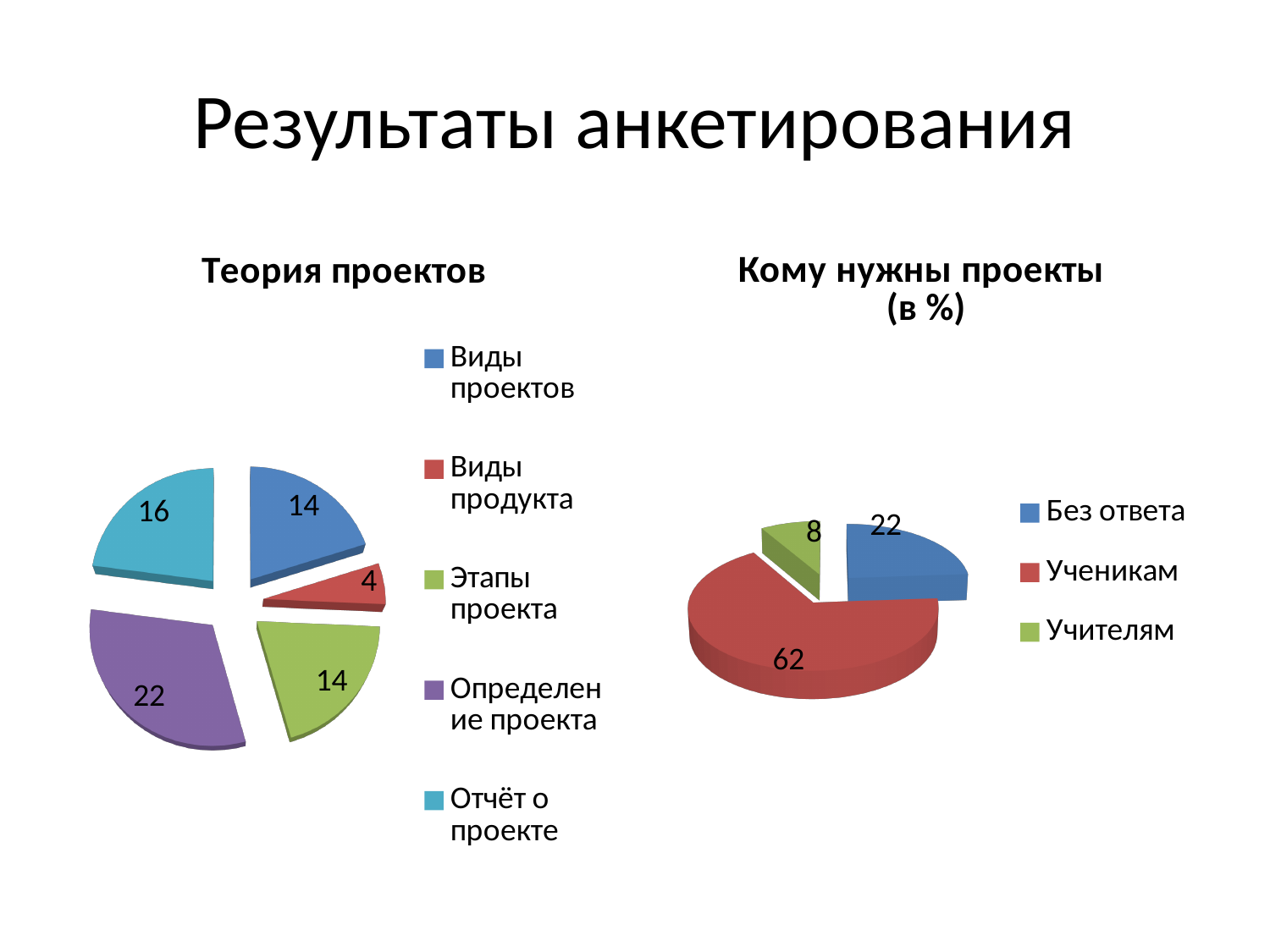
In the chart titled "Теория проектов", what is the value for "Виды продукта"? 4 In the chart titled "Теория проектов", which category has the smallest value? Виды продукта In the chart titled "Кому нужны проекты (в %)", what is the value for "Учителям"? 8 In the chart titled "Кому нужны проекты (в %)", what is the difference between the values for "Ученикам" and "Без ответа"? 40 In the chart titled "Теория проектов", which category has the largest value? Определение проекта In the chart titled "Теория проектов", how many categories are shown? 5 In the chart titled "Теория проектов", what is the value for "Определение проекта"? 22 In the chart titled "Кому нужны проекты (в %)", which category has the largest value? Ученикам In the chart titled "Кому нужны проекты (в %)", how many entries does the legend list? 3 What kind of chart is the chart titled "Теория проектов"? Pie chart In the chart titled "Теория проектов", what is the difference between the values for "Отчёт о проекте" and "Виды проектов"? 2 In the chart titled "Кому нужны проекты (в %)", what is the value for "Ученикам"? 62